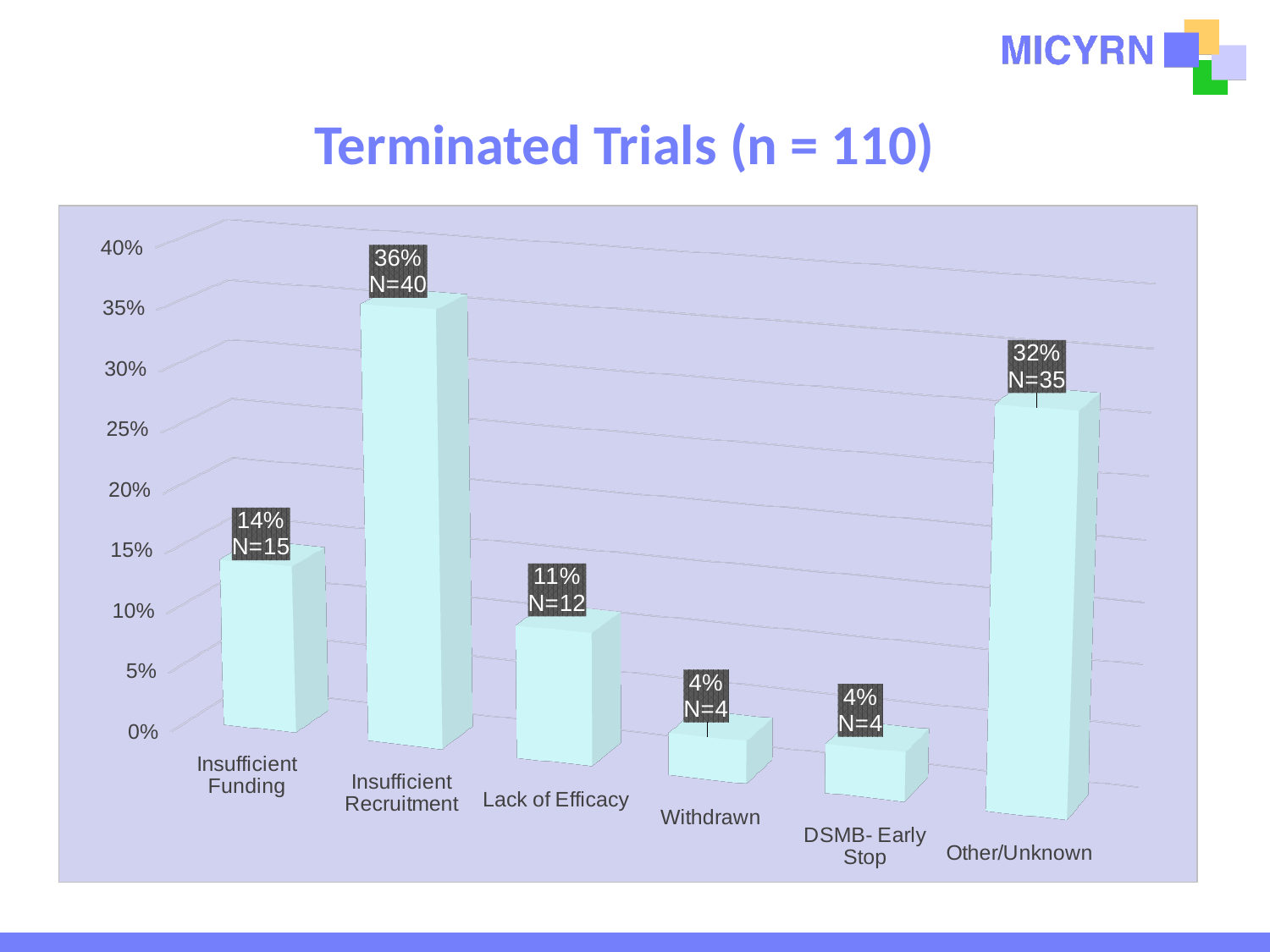
Which two categories share the same percentage of 4%? Withdrawn and DSMB- Early Stop How many trials (N) were terminated due to Lack of Efficacy? N=12 What is the difference in the number of trials between Insufficient Funding and Lack of Efficacy? 3 Which category has the highest percentage of terminated trials? Insufficient Recruitment What percentage of terminated trials is attributed to Insufficient Recruitment? 36% Which is larger, the percentage for Insufficient Funding or for Lack of Efficacy? Insufficient Funding What is the difference in percentage points between Insufficient Recruitment and Other/Unknown? 4 Is the value for Other/Unknown greater or less than 30%? greater What kind of chart is shown on the slide? Bar chart What percentage of terminated trials falls under Other/Unknown? 32% What is the title of the chart? Terminated Trials (n = 110) How many categories are shown on the x axis? 6